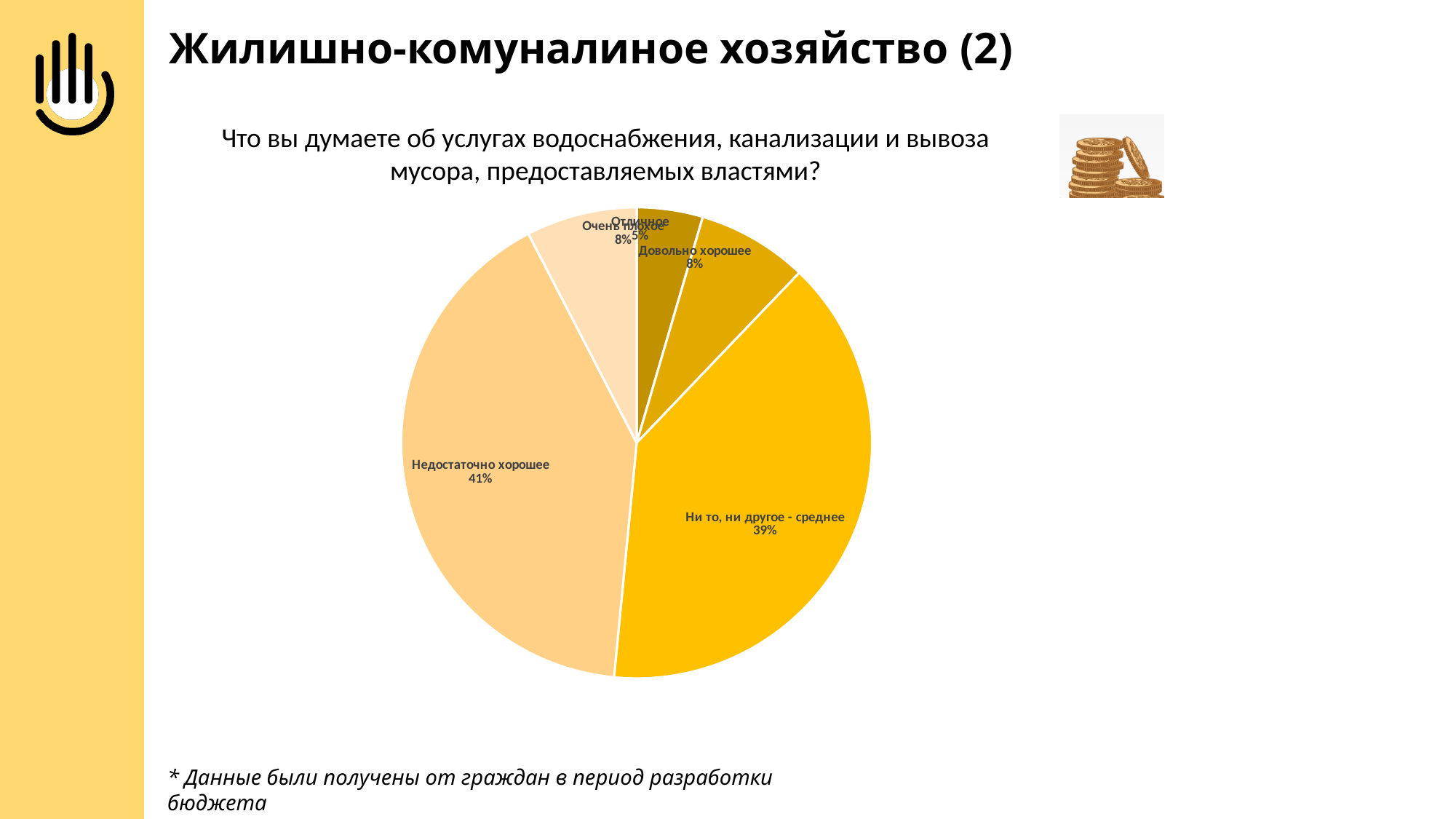
How many slices does the pie chart have? 5 What share of the pie is labelled "Ни то, ни другое - среднее"? 39% Which is larger: the share for "Довольно хорошее" or the share for "Отличное"? Довольно хорошее What question is the pie chart answering, according to the text above it? Что вы думаете об услугах водоснабжения, канализации и вывоза мусора, предоставляемых властями? What share of the pie is labelled "Очень плохое"? 8% What share of the pie is labelled "Довольно хорошее"? 8% What is the difference in percentage points between "Недостаточно хорошее" and "Ни то, ни другое - среднее"? 2 What kind of chart is shown on the slide? pie chart Which category has the smallest slice of the pie? Отличное Which category has the largest slice of the pie? Недостаточно хорошее